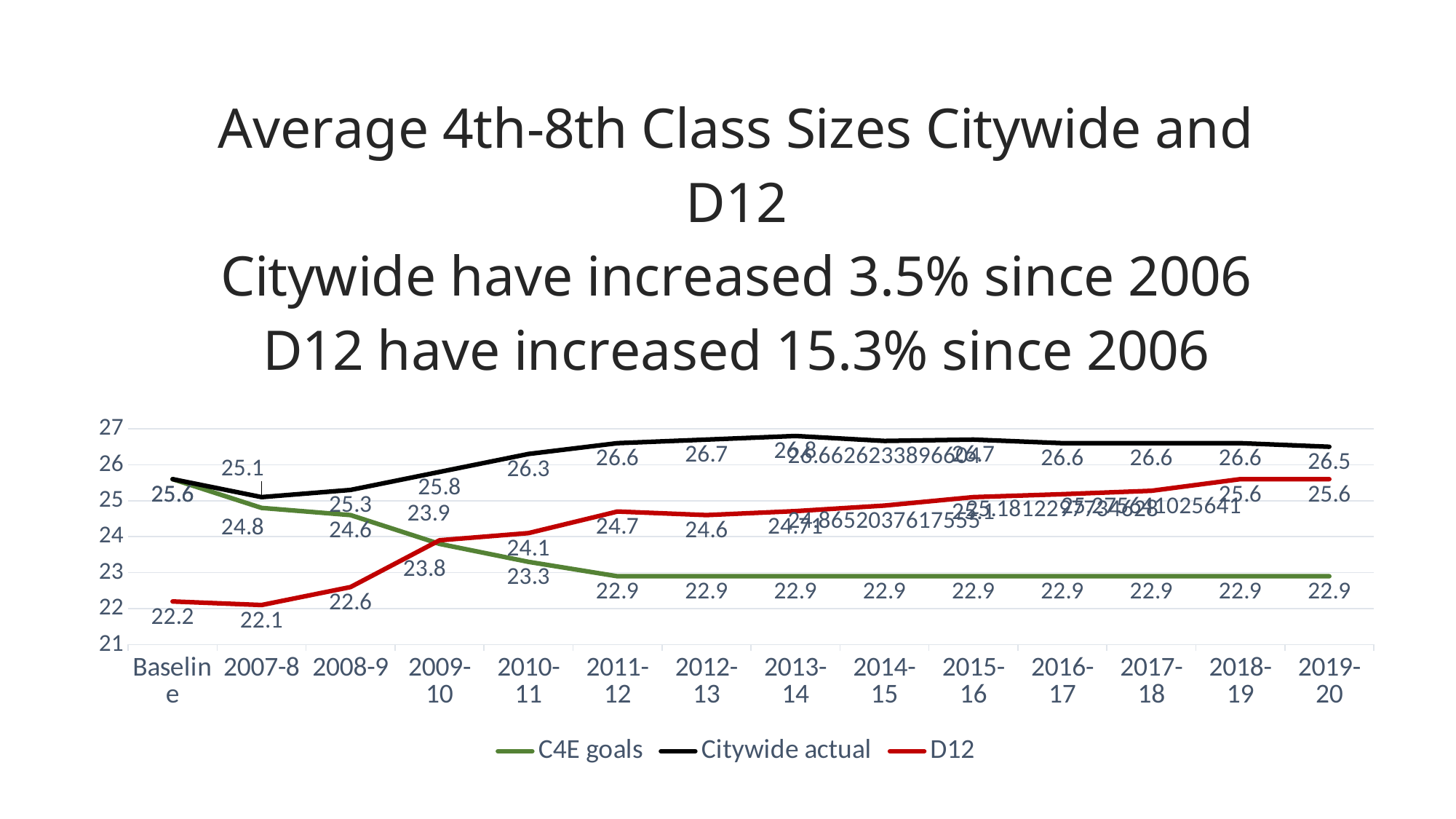
What is the difference between the Citywide actual and D12 values for 2019-20? 0.9 What is the C4E goals value for 2009-10? 23.8 What is the D12 value for 2008-9? 22.6 Which colour is used for the D12 series? red How many series does the legend list? 3 In which category is the D12 value lowest? 2007-8 For 2011-12, which is larger: Citywide actual or D12? Citywide actual How many categories are shown along the x axis? 14 What is the Citywide actual value for 2019-20? 26.5 What kind of chart is shown on the slide? line chart What is the Citywide actual value for 2010-11? 26.3 Is the Citywide actual value for 2013-14 greater or less than 26? greater